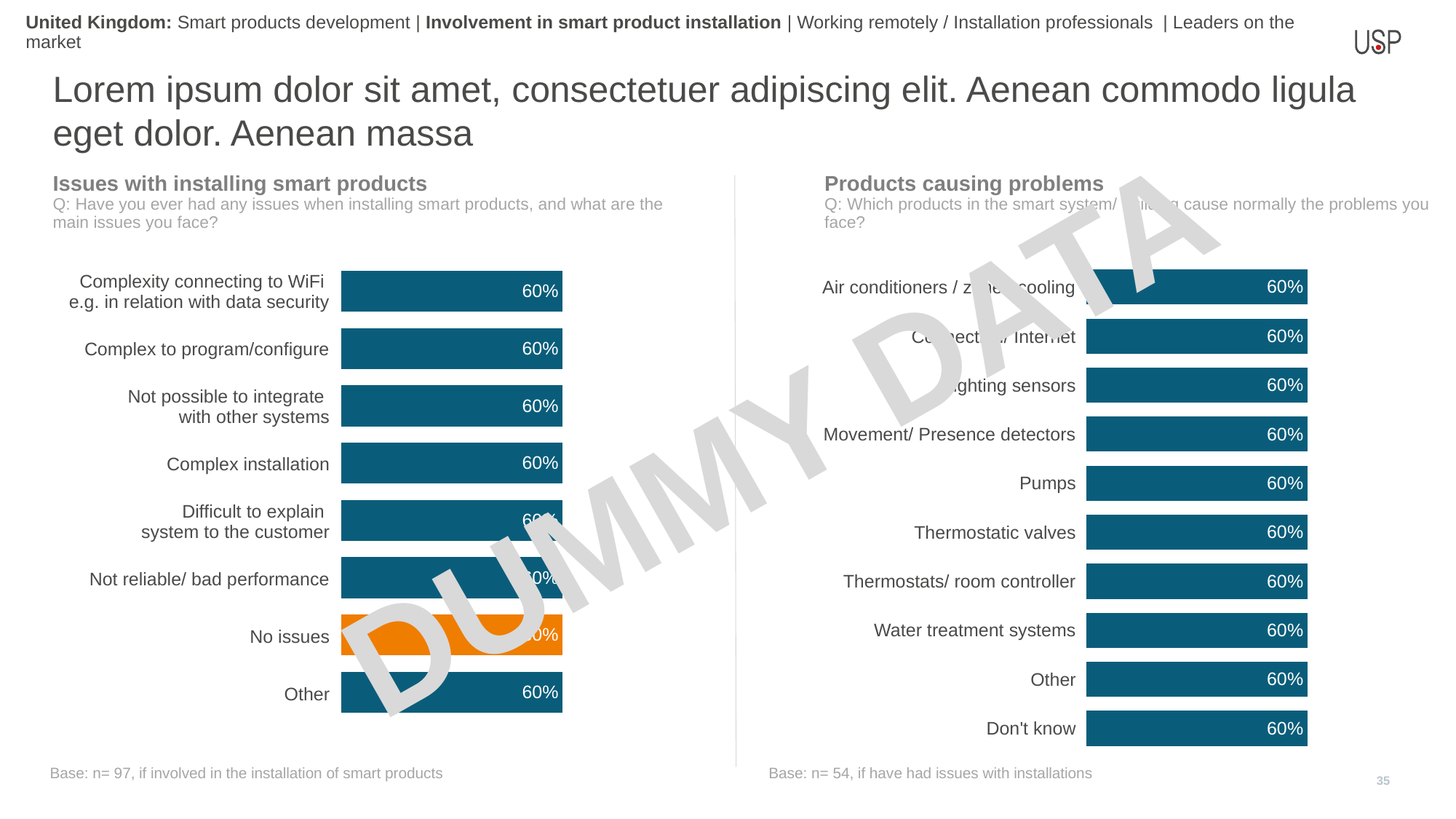
In the 'Products causing problems' chart, what is the value for 'Pumps'? 60% In the 'Issues with installing smart products' chart, what is the value for 'Complex installation'? 60% What type of chart is the 'Products causing problems' chart? Bar chart What is the base (n) stated below the 'Products causing problems' chart? n= 54 In the 'Issues with installing smart products' chart, what is the value for 'Other'? 60% In the 'Products causing problems' chart, what is the value for 'Water treatment systems'? 60% In the 'Products causing problems' chart, what is the value for 'Don't know'? 60% How many categories are shown in the 'Issues with installing smart products' chart? 8 In the 'Issues with installing smart products' chart, what is the value for 'Complex to program/configure'? 60% In the 'Products causing problems' chart, what is the difference between the values for 'Thermostatic valves' and 'Thermostats/ room controller'? 0% In the 'Issues with installing smart products' chart, which category's bar is coloured orange instead of blue? No issues How many categories are shown in the 'Products causing problems' chart? 10